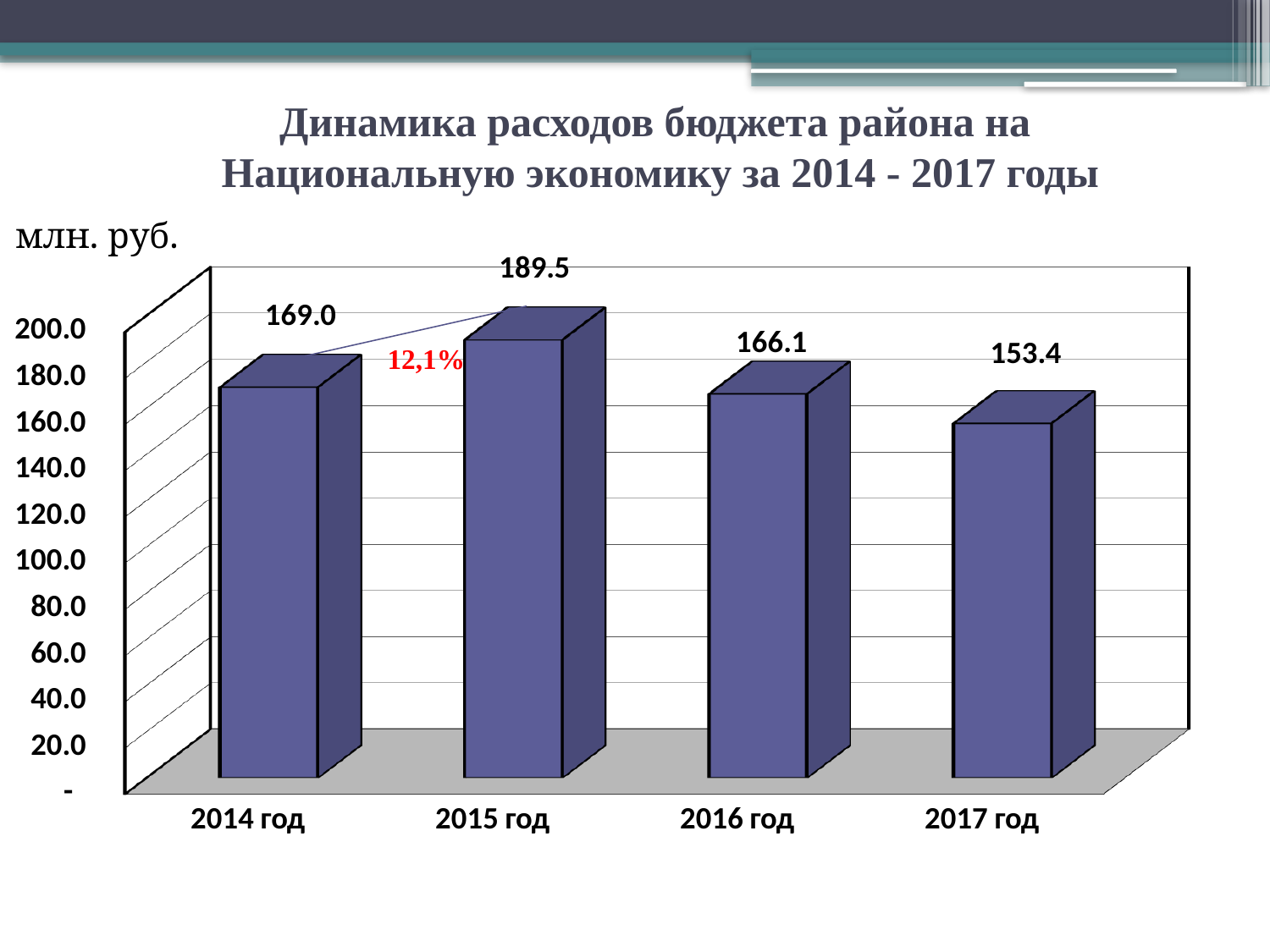
What is the value for 2014 год? 169.0 Which year has the highest value? 2015 год What is the difference between the values for 2016 год and 2017 год? 12.7 What is the difference between the values for 2015 год and 2014 год? 20.5 How many years are shown on the chart? 4 Which is larger, the value for 2014 год or the value for 2016 год? 2014 год What kind of chart is shown on the slide? bar chart What is the value for 2017 год? 153.4 What percentage change is annotated in red between 2014 год and 2015 год? 12,1% What is the value for 2015 год? 189.5 Which year has the lowest value? 2017 год What is the value for 2016 год? 166.1